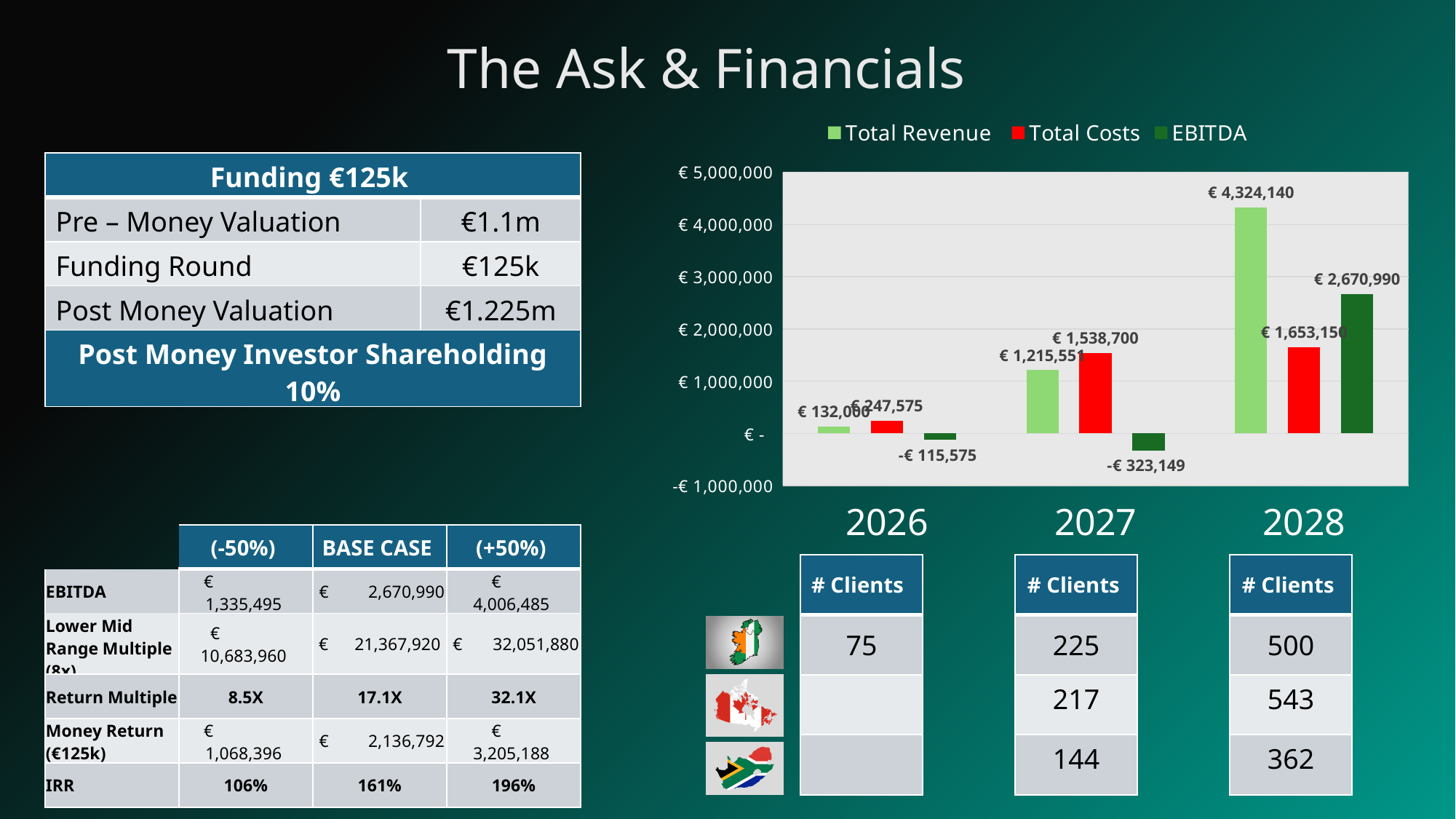
What is the EBITDA value shown for 2027? -€ 323,149 Which year has the lowest EBITDA? 2027 By how much do Total Costs exceed Total Revenue in 2027? € 323,149 Is the Total Costs value for 2028 greater or less than € 2,000,000? less What is the Total Costs value shown for 2027? € 1,538,700 How many series does the chart legend list? 3 What is the Total Revenue value shown for 2027? € 1,215,551 Which year has the highest Total Revenue? 2028 What is the Total Revenue value shown for 2028? € 4,324,140 In 2027, which is larger: Total Revenue or Total Costs? Total Costs What is the EBITDA value shown for 2028? € 2,670,990 What is the EBITDA value shown for 2026? -€ 115,575